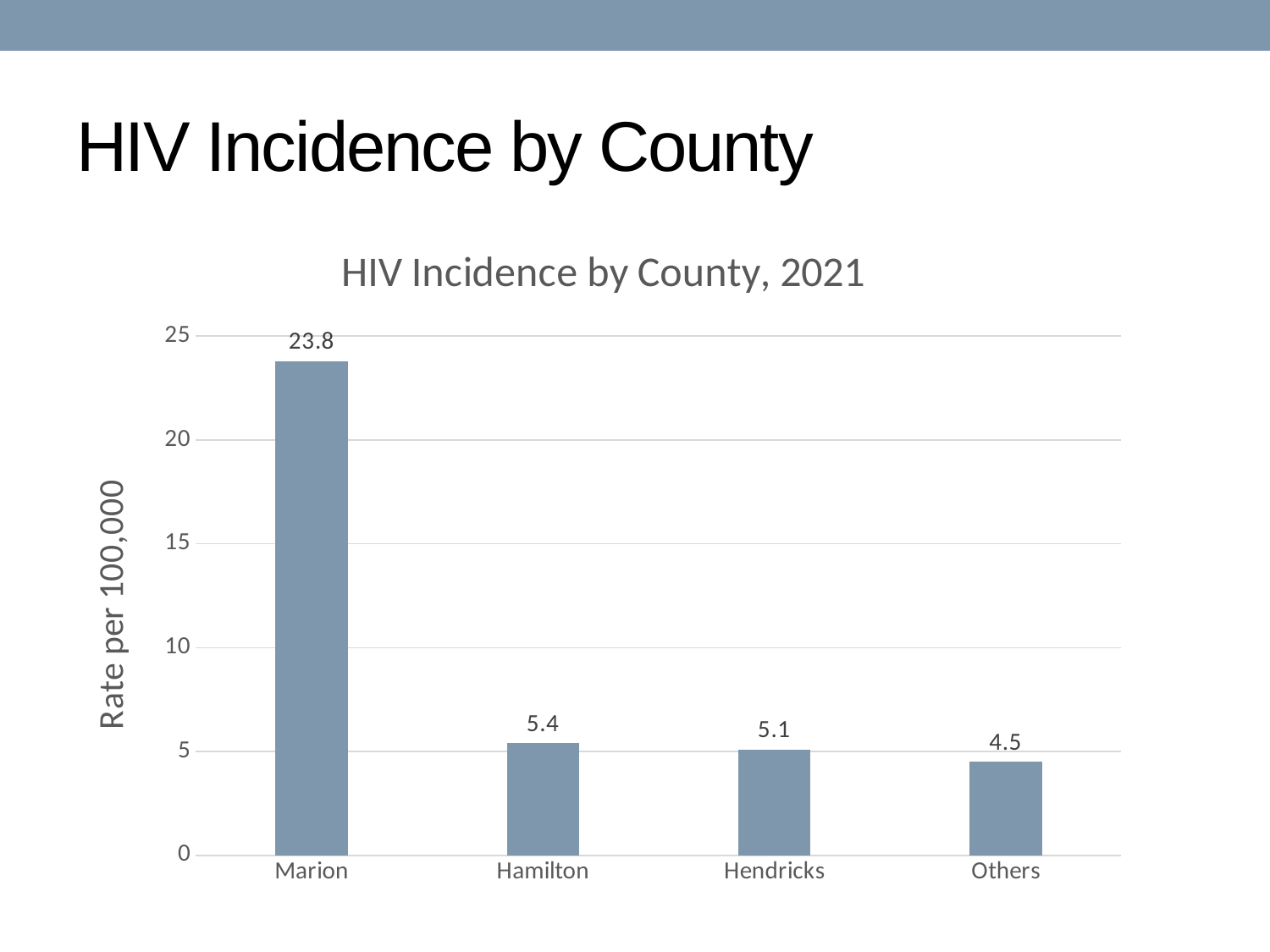
What is the HIV incidence rate for Hamilton? 5.4 What is the difference between the HIV incidence rates for Marion and Hamilton? 18.4 Which county has the highest HIV incidence rate? Marion What kind of chart is shown on the slide? Bar chart What is the difference between the HIV incidence rates for Hendricks and Others? 0.6 How many categories are shown on the x axis? 4 Which has a higher HIV incidence rate, Hamilton or Hendricks? Hamilton What is the HIV incidence rate for Others? 4.5 Is the value for Marion greater or less than 20? greater What is the HIV incidence rate for Hendricks? 5.1 What is the HIV incidence rate for Marion? 23.8 Which category has the lowest HIV incidence rate? Others